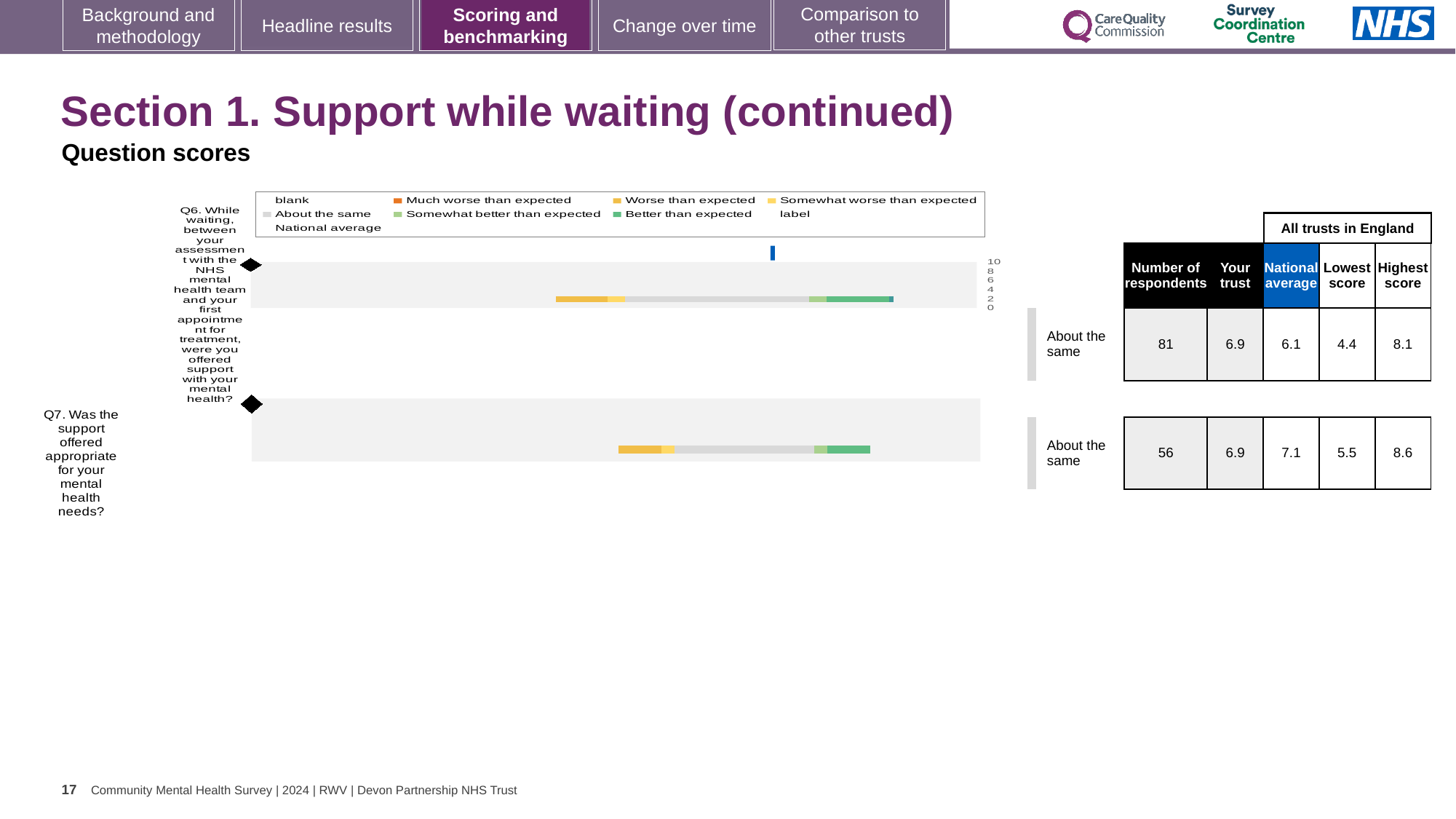
How many respondents answered Q7? 56 How many respondents answered Q6? 81 What is the highest score among all trusts in England for Q7? 8.6 What colour is the 'Better than expected' legend entry? green What kind of chart is shown on the slide? bar chart What is the lowest score among all trusts in England for Q6? 4.4 What is the national average score for Q7? 7.1 What benchmark category is shown for Q6? About the same Which is larger for Q7: the trust's score or the national average? National average What is the difference between the trust's score and the national average for Q6? 0.8 What is the 'Your trust' score for Q6? 6.9 How many questions (bars) are plotted in the chart? 2